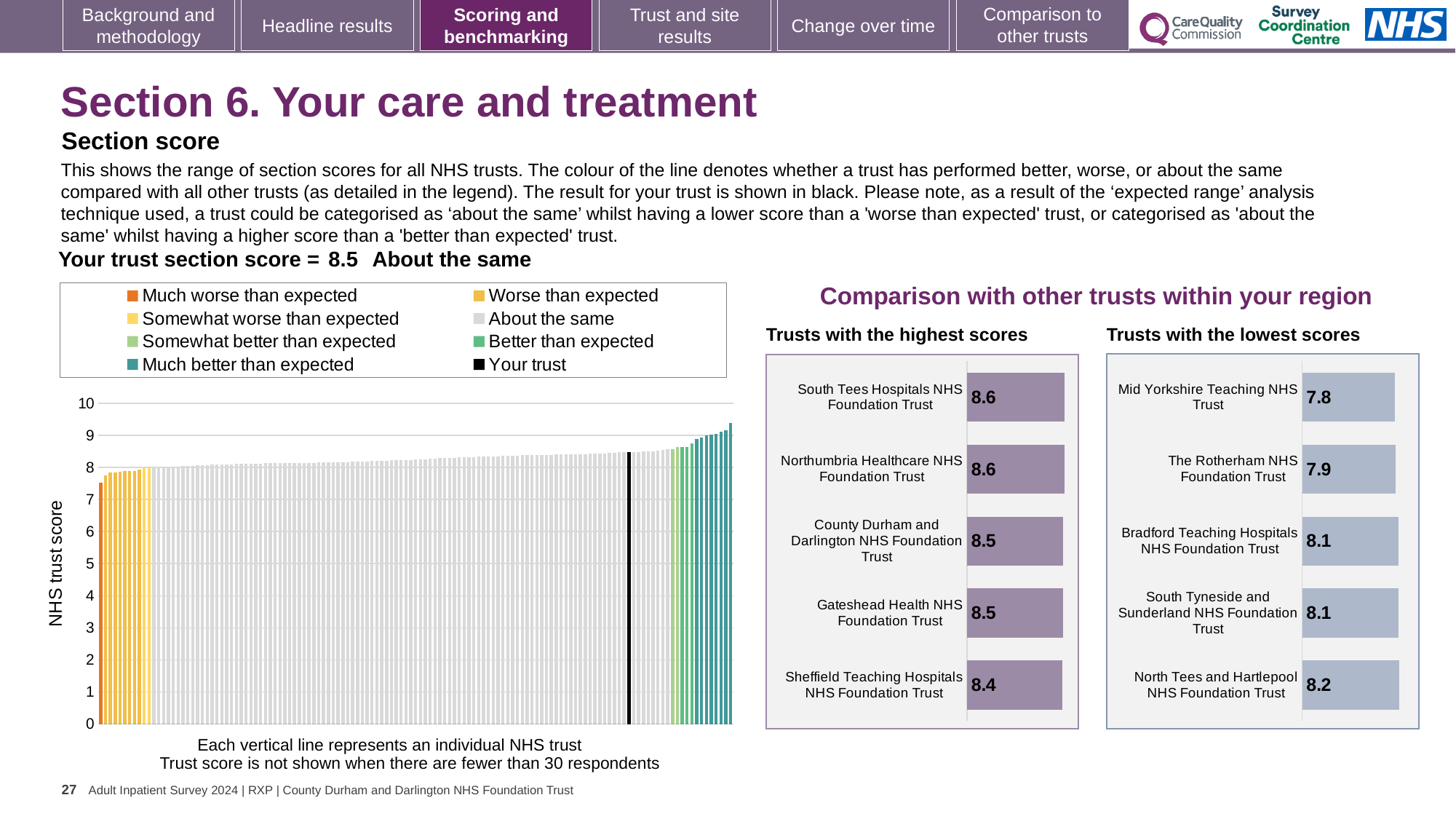
In the 'Trusts with the lowest scores' chart, what is the score for Mid Yorkshire Teaching NHS Trust? 7.8 In the 'Trusts with the lowest scores' chart, which trust has the highest score? North Tees and Hartlepool NHS Foundation Trust In the 'Trusts with the lowest scores' chart, which has the larger score: The Rotherham NHS Foundation Trust or Bradford Teaching Hospitals NHS Foundation Trust? Bradford Teaching Hospitals NHS Foundation Trust In the left-hand chart, is the value for your trust (the black bar) greater or less than 8? greater How many entries does the legend of the left-hand chart list? 8 What kind of chart is the large chart on the left showing the range of NHS trust scores? bar chart In the 'Trusts with the highest scores' chart, what is the difference between the scores of South Tees Hospitals NHS Foundation Trust and Sheffield Teaching Hospitals NHS Foundation Trust? 0.2 In the left-hand chart, do the trust scores rise or fall from left to right along the x axis? rise In the 'Trusts with the highest scores' chart, how many trusts are shown? 5 What is the label of the y axis on the left-hand chart? NHS trust score In the 'Trusts with the highest scores' chart, what is the score for Sheffield Teaching Hospitals NHS Foundation Trust? 8.4 In the 'Trusts with the highest scores' chart, which trust has the lowest score? Sheffield Teaching Hospitals NHS Foundation Trust